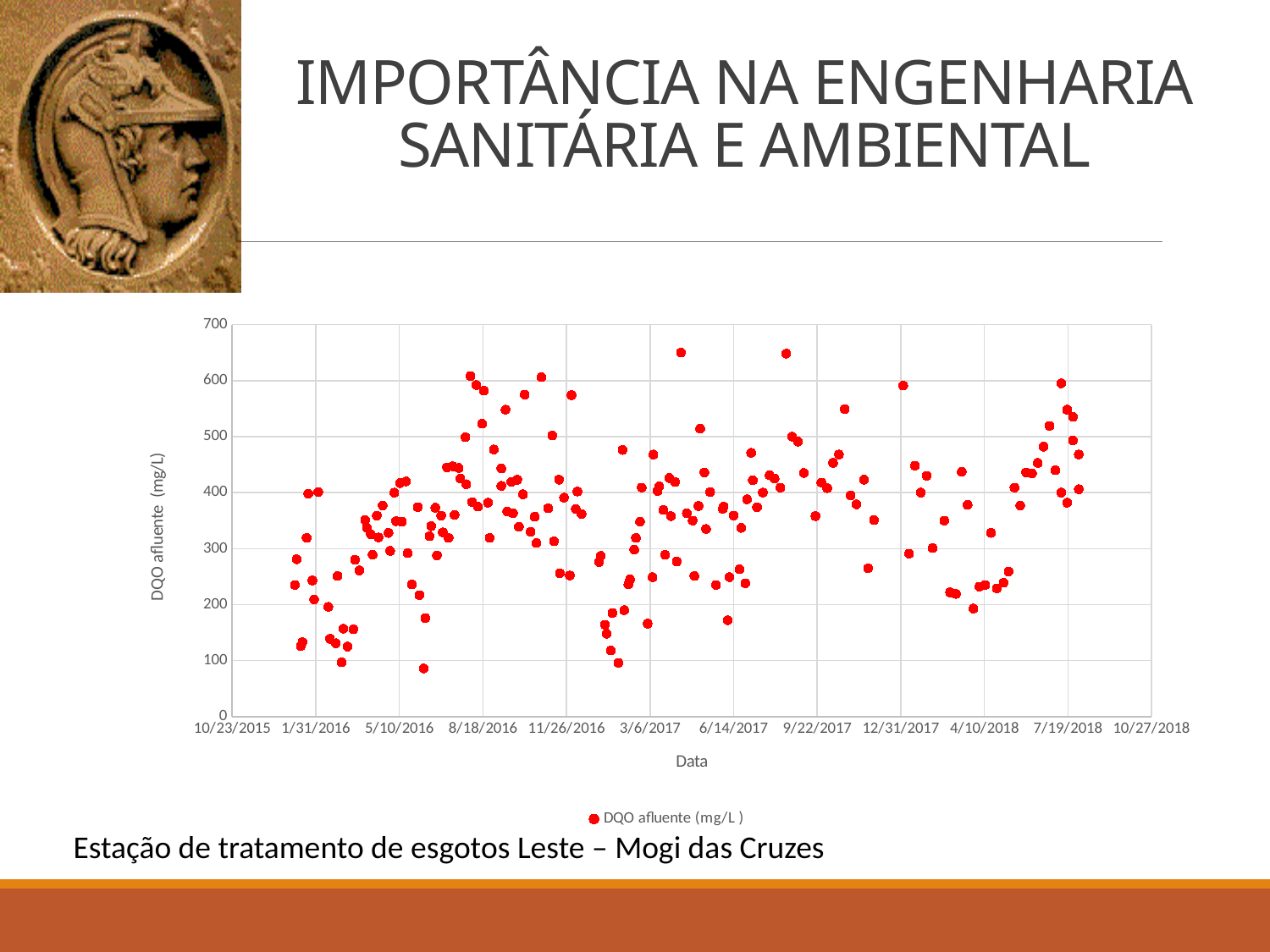
How many series does the legend list? 1 What kind of chart is shown on the slide? scatter chart What is the title of the vertical axis? DQO afluente (mg/L) Is the highest plotted DQO afluente value greater or less than 700? less Is the highest plotted DQO afluente value greater or less than 600? greater What is the name of the series shown in the legend? DQO afluente (mg/L ) Is the lowest plotted DQO afluente value greater or less than 200? less